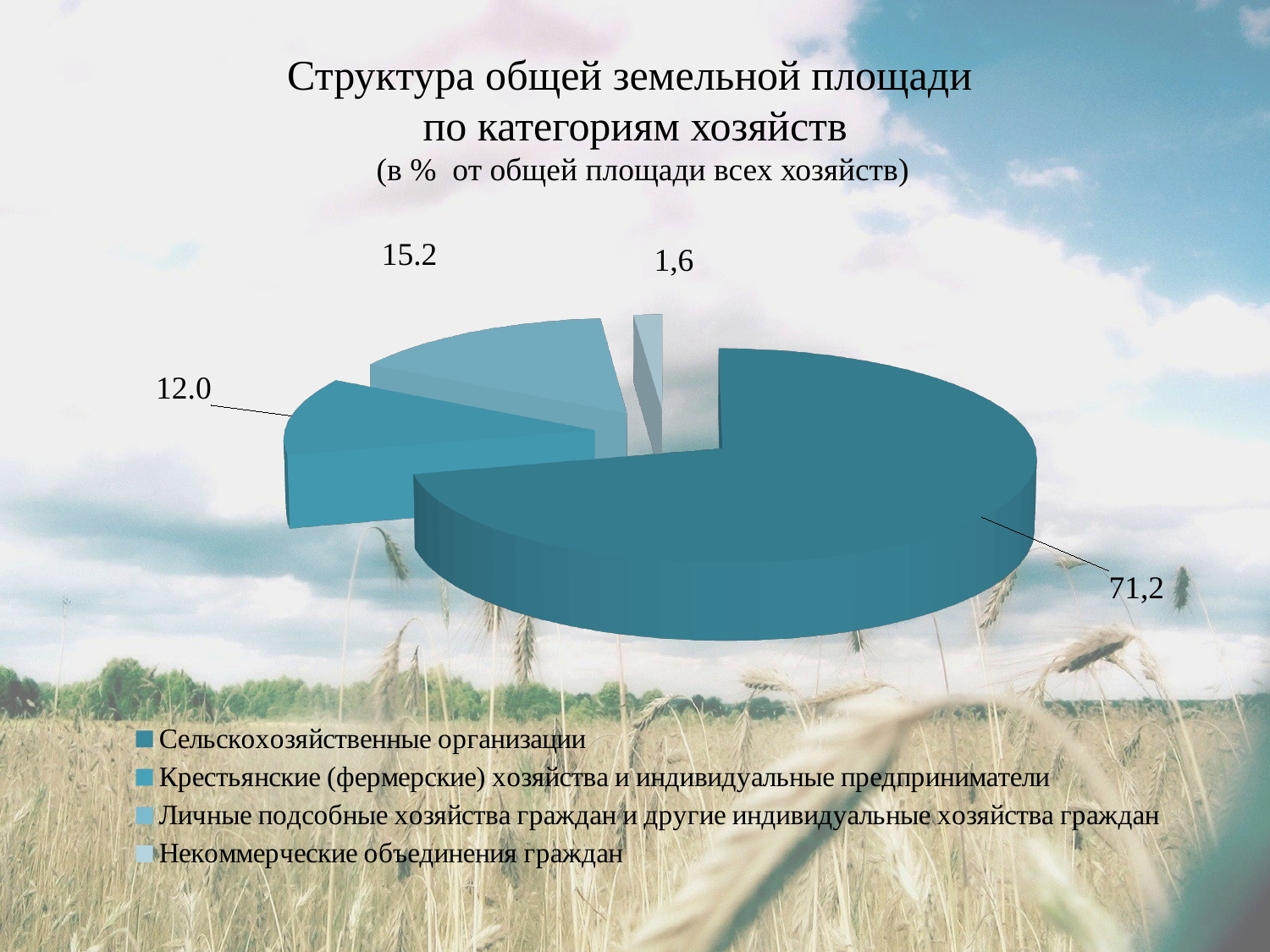
Which is larger: the share for Личные подсобные хозяйства граждан or for Крестьянские (фермерские) хозяйства? Личные подсобные хозяйства граждан What is the difference between the values for Сельскохозяйственные организации and Крестьянские (фермерские) хозяйства? 59.2 What is the value for Сельскохозяйственные организации? 71,2 What is the value for Некоммерческие объединения граждан? 1,6 What is the difference between the values for Личные подсобные хозяйства граждан and Некоммерческие объединения граждан? 13.6 What is the title of the chart? Структура общей земельной площади по категориям хозяйств (в % от общей площади всех хозяйств) Which category has the largest share of the pie? Сельскохозяйственные организации What kind of chart is shown on the slide? Pie chart Which category has the smallest share of the pie? Некоммерческие объединения граждан How many slices does the pie chart have? 4 What is the value for Личные подсобные хозяйства граждан и другие индивидуальные хозяйства граждан? 15.2 What is the value for Крестьянские (фермерские) хозяйства и индивидуальные предприниматели? 12.0